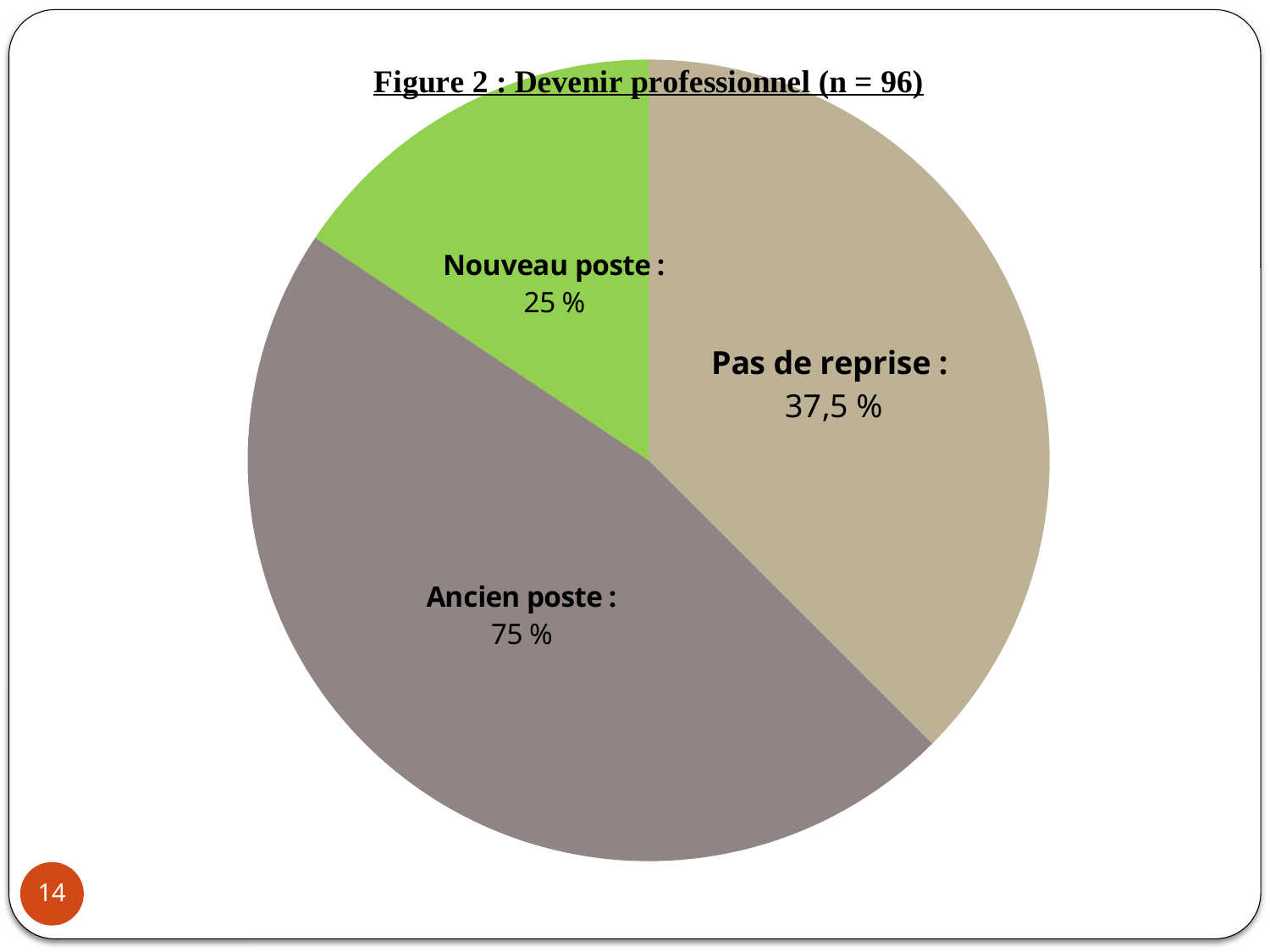
What is the difference between the percentages for "Pas de reprise" and "Nouveau poste"? 12,5 % What kind of chart is shown on the slide? pie chart Which is larger, the percentage for "Pas de reprise" or for "Nouveau poste"? Pas de reprise What percentage is shown for "Pas de reprise"? 37,5 % How many slices does the pie chart have? 3 Which slice has the smallest percentage? Nouveau poste What percentage is shown for "Ancien poste"? 75 % What is the title of the chart? Figure 2 : Devenir professionnel (n = 96) What share of the pie is labelled for "Nouveau poste"? 25 % What is the sample size (n) given in the chart title? 96 What percentage is shown for "Nouveau poste"? 25 % Which slice has the largest printed percentage? Ancien poste